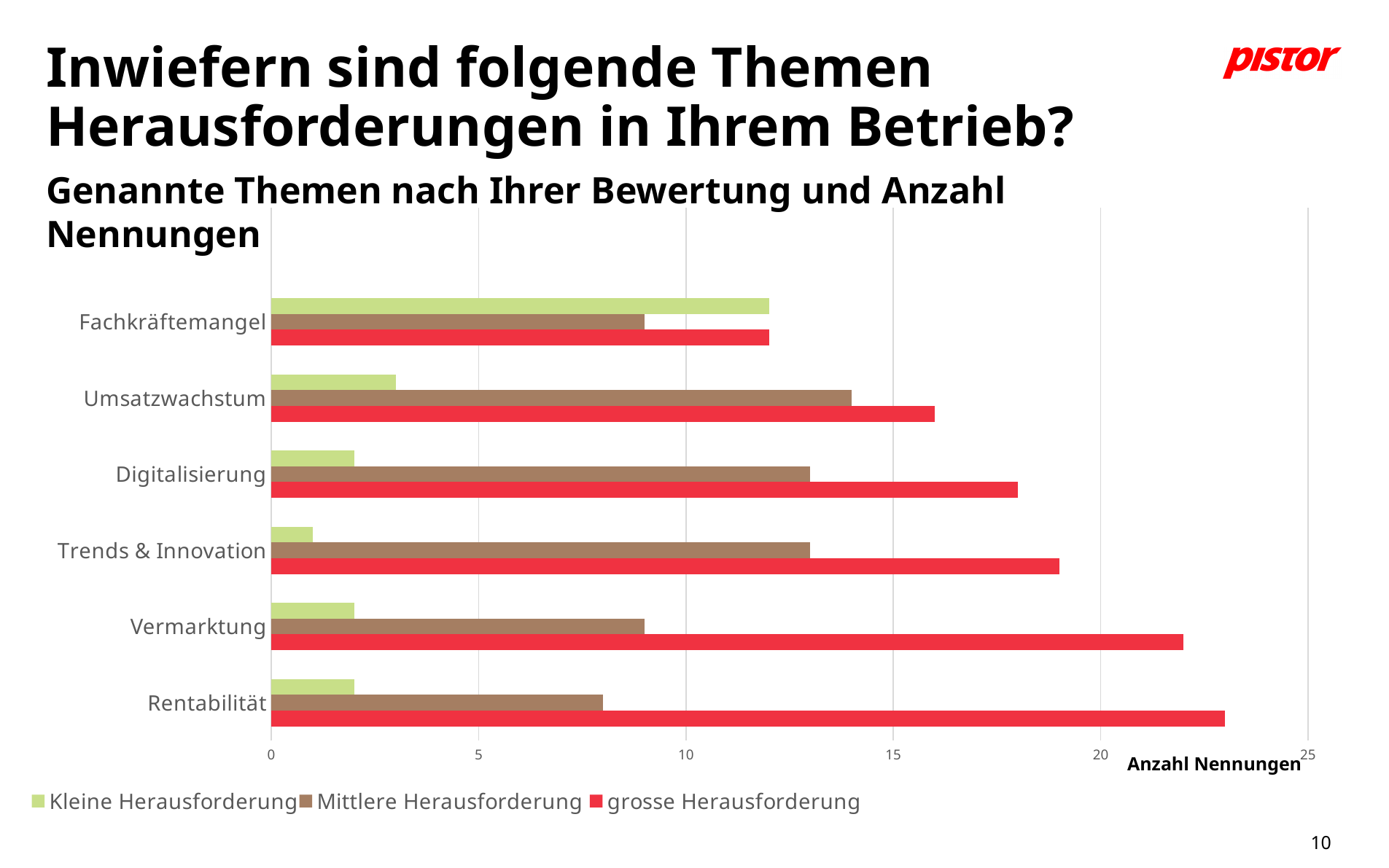
How many series does the legend list? 3 Is the 'Mittlere Herausforderung' value for Digitalisierung greater or less than 10? greater Which topic has the highest value for 'Kleine Herausforderung'? Fachkräftemangel Is the 'Kleine Herausforderung' value for Umsatzwachstum greater or less than 5? less How many topics (categories) are listed on the chart? 6 What is the label of the horizontal axis? Anzahl Nennungen What kind of chart is shown on the slide? bar chart Which topic has the lowest value for 'grosse Herausforderung'? Fachkräftemangel Is the 'Mittlere Herausforderung' value for Rentabilität greater or less than 10? less Which is larger: the 'grosse Herausforderung' value for Digitalisierung or for Fachkräftemangel? Digitalisierung For Umsatzwachstum, which is larger: 'Kleine Herausforderung' or 'grosse Herausforderung'? grosse Herausforderung